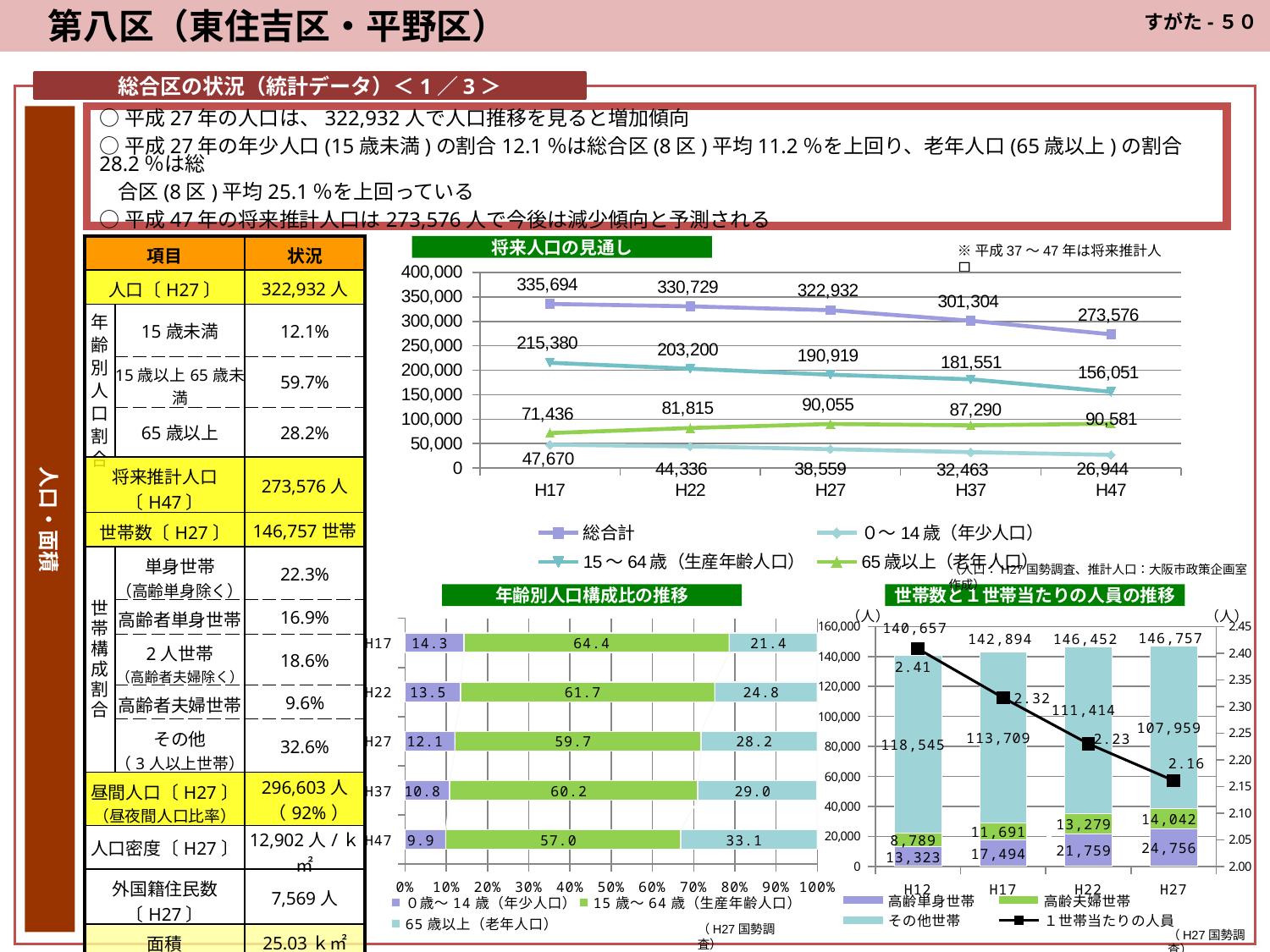
In the 年齢別人口構成比の推移 chart, what is the 65歳以上（老年人口） share for H37? 29.0 In the 世帯数と１世帯当たりの人員の推移 chart, which is larger: その他世帯 in H12 or in H27? H12 In the 将来人口の見通し chart, what is the value for 65歳以上（老年人口） at H47? 90,581 In the 世帯数と１世帯当たりの人員の推移 chart, what is the 1世帯当たりの人員 value for H22? 2.23 In the 将来人口の見通し chart, what is the difference between the 総合計 values for H17 and H47? 62,118 What kind of chart is the 年齢別人口構成比の推移 chart? stacked bar chart In the 世帯数と１世帯当たりの人員の推移 chart, what is the 高齢単身世帯 value for H27? 24,756 In the 年齢別人口構成比の推移 chart, which year has the highest 0歳～14歳（年少人口） share? H17 In the 将来人口の見通し chart, what is the 総合計 value for H27? 322,932 How many series does the legend of the 将来人口の見通し chart list? 4 In the 将来人口の見通し chart, which year has the lowest 0～14歳（年少人口） value? H47 In the 将来人口の見通し chart, does the 15～64歳（生産年齢人口） series rise or fall from H17 to H47? fall